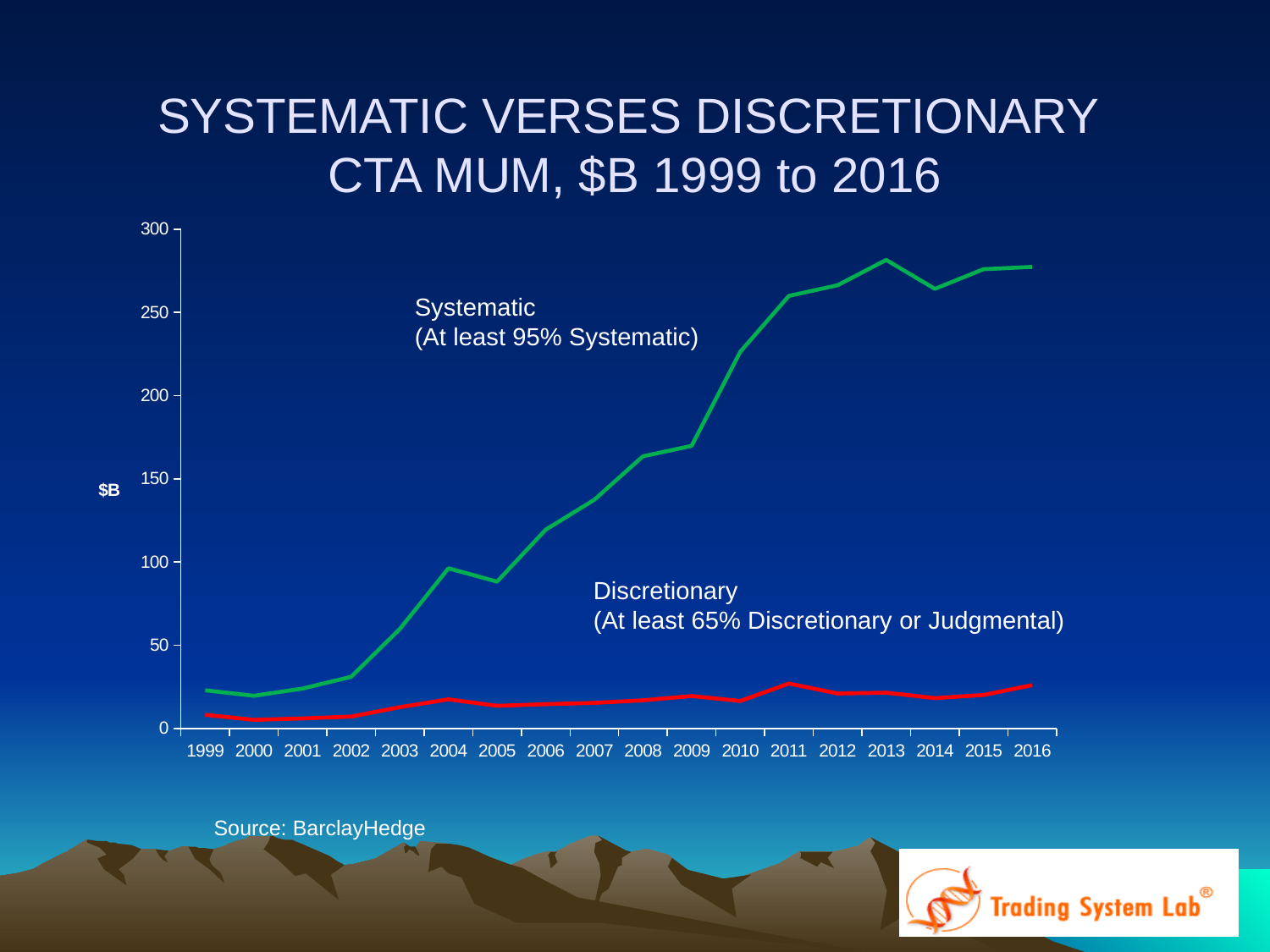
Is the Discretionary value for 2016 greater or less than 50? less Is the Systematic value for 2010 greater or less than 200? greater Is the Systematic value for 2002 greater or less than 50? less Is the Systematic value larger in 2013 or in 2014? 2013 What is the source cited below the chart? BarclayHedge Does the Systematic series generally rise or fall from 1999 to 2016? Rise In which year does the Systematic series reach its highest value? 2013 Which series is higher in 2016, Systematic or Discretionary? Systematic How many series are plotted on the chart? 2 What kind of chart is shown on the slide? Line chart How many years are shown along the x axis of the chart? 18